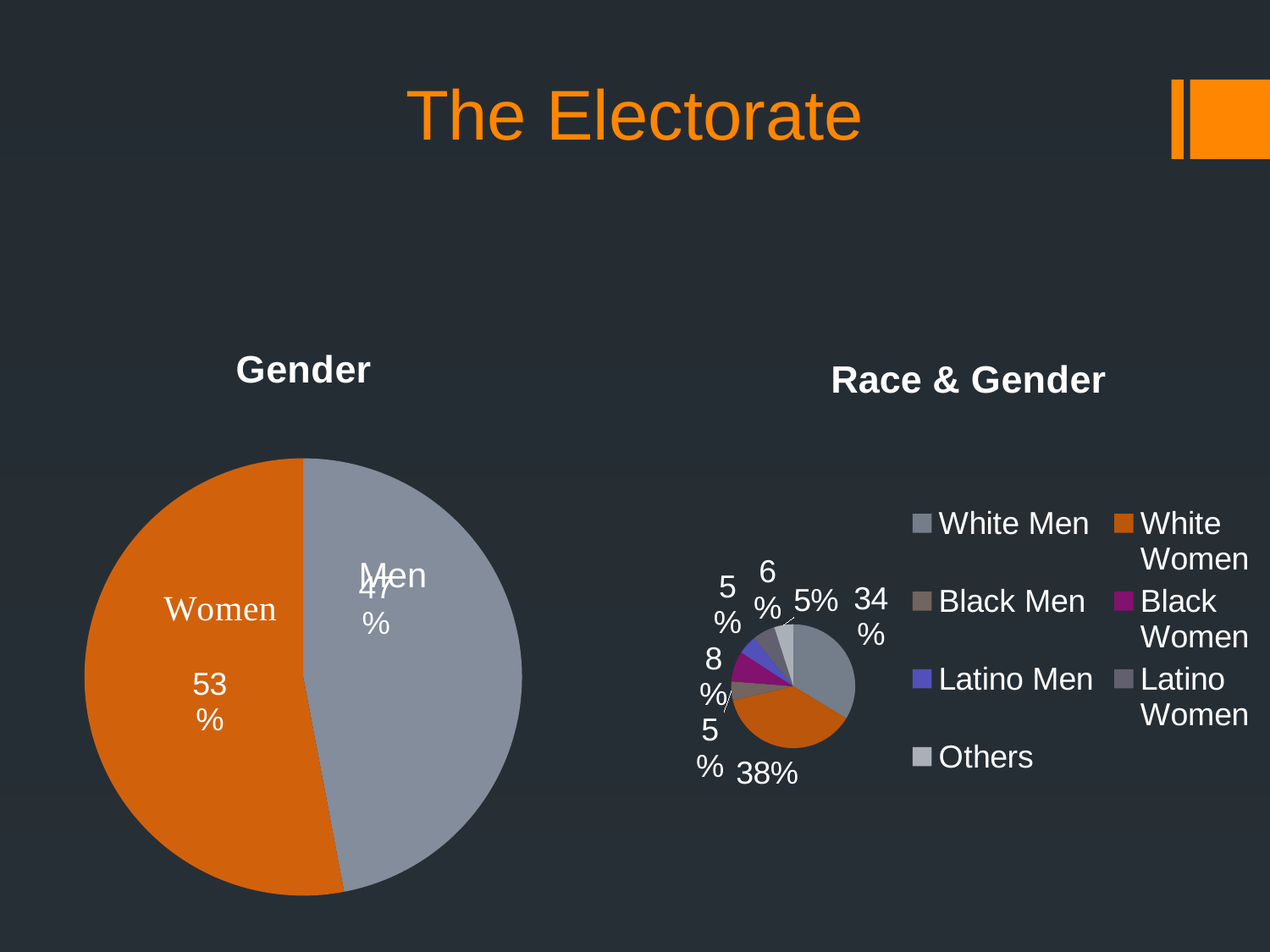
In the Gender chart, what is the difference between the Women and Men shares? 6% In the Race & Gender chart, which category has the largest share? White Women What kind of chart is the Gender chart? pie chart In the Race & Gender chart, what share is Black Women? 8% In the Gender chart, which group has the larger share, Women or Men? Women What is the title of the chart on the right side of the slide? Race & Gender In the Gender chart, what share of the electorate is Women? 53% In the Race & Gender chart, what is the difference between the White Women and White Men shares? 4% In the Race & Gender chart, what share is White Women? 38% In the Gender chart, what share of the electorate is Men? 47% In the Race & Gender chart, what share is White Men? 34% How many categories does the Race & Gender chart's legend list? 7